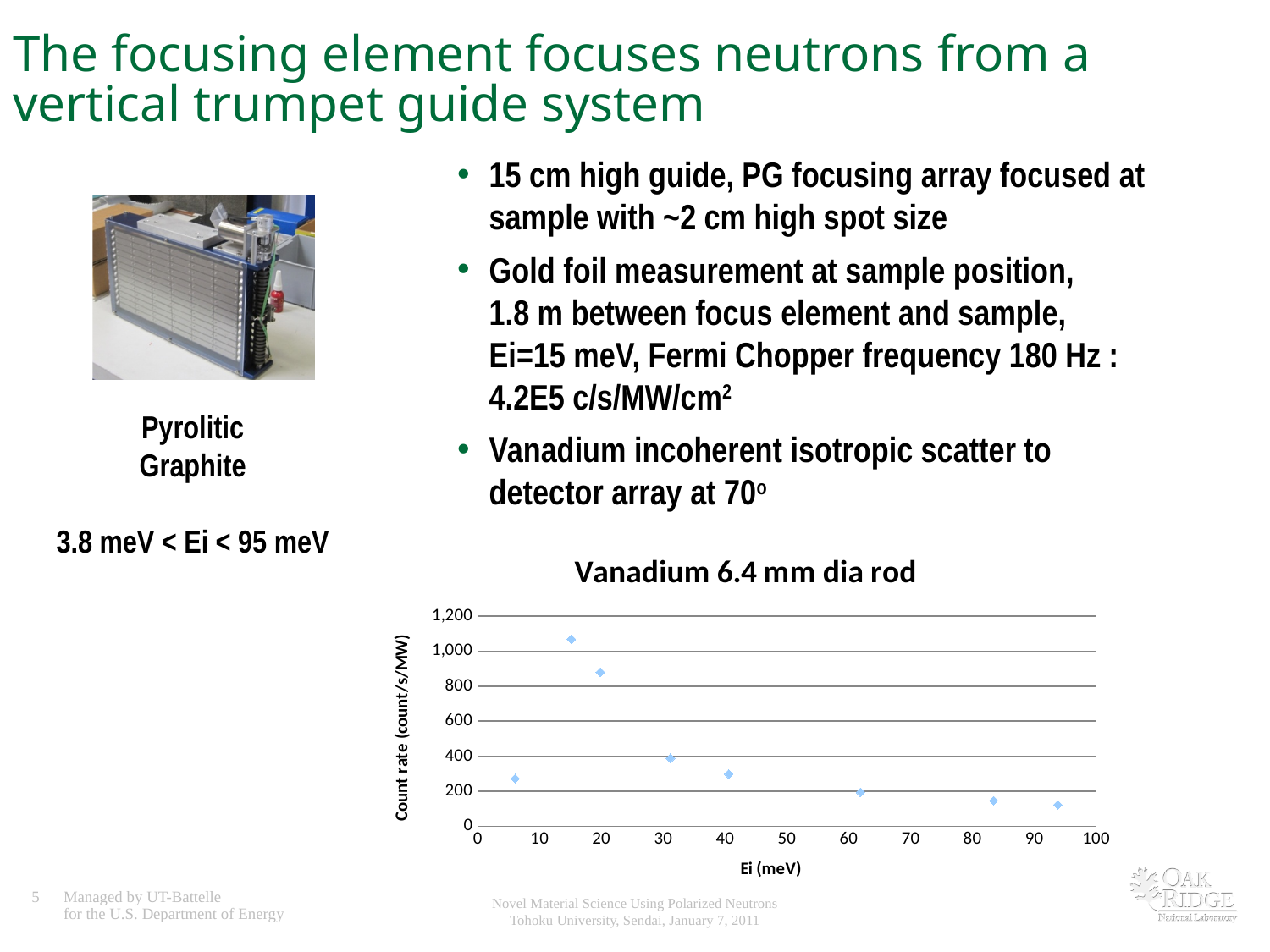
What is the label of the y axis of the chart? Count rate (count/s/MW) Is the count rate for the point near Ei = 15 meV greater or less than 1,000? greater Is the count rate for the point near Ei = 20 meV greater or less than 800? greater Is the count rate for the point near Ei = 6 meV greater or less than 200? greater Which has the higher count rate: the point near Ei = 15 meV or the point near Ei = 20 meV? the point near Ei = 15 meV After the peak near Ei = 15 meV, do the count rates rise or fall as Ei increases? fall What kind of chart is shown under the title "Vanadium 6.4 mm dia rod"? scatter plot How many data points are plotted in the chart? 8 What is the title of the chart on the slide? Vanadium 6.4 mm dia rod